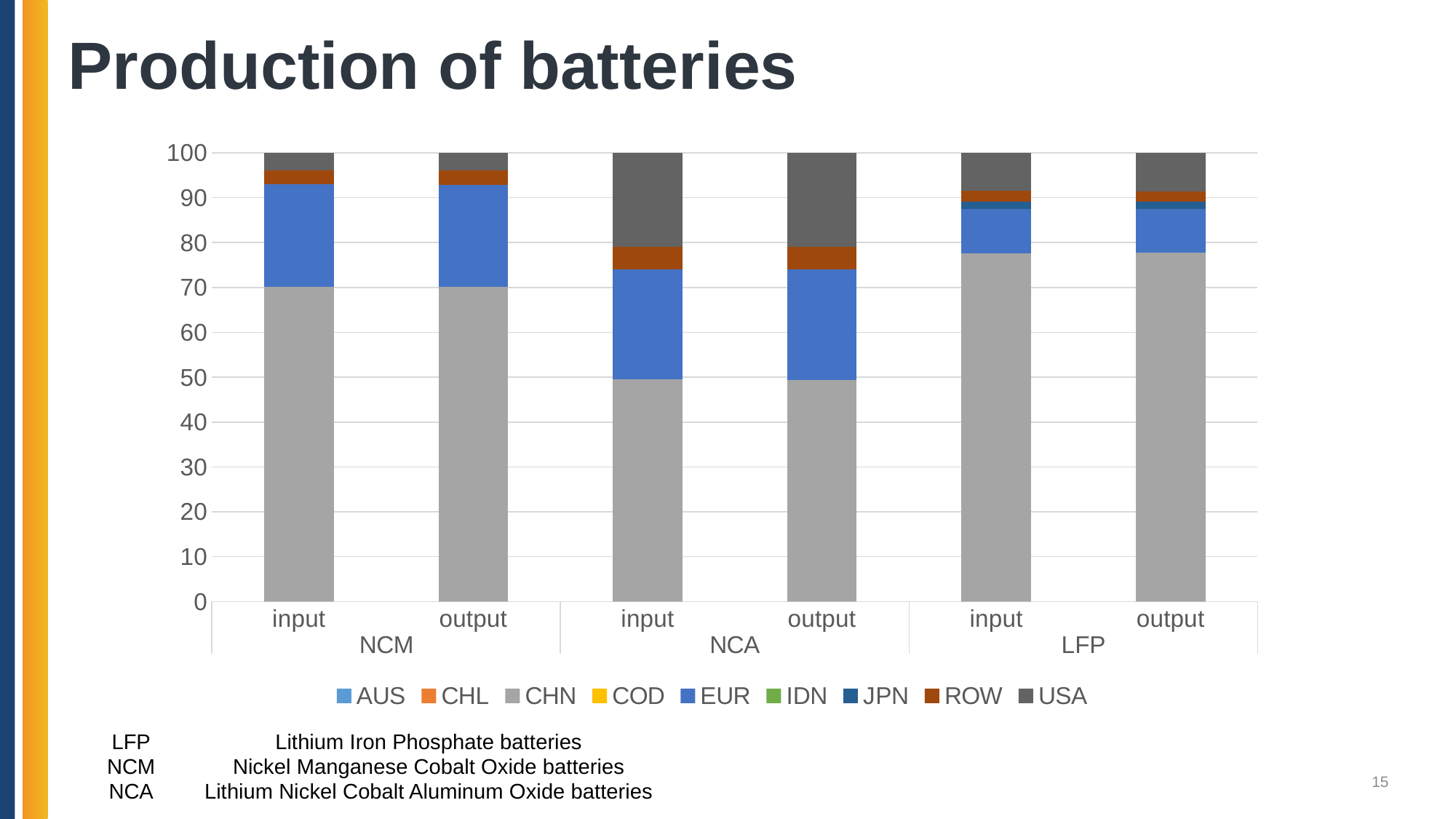
Is the EUR share larger in the NCA input bar or in the LFP input bar? NCA input Is the CHN share of the LFP output bar greater or less than 70? greater How many series does the legend list? 9 Is the CHN share of the NCM input bar greater or less than 60? greater Is the CHN share of the NCA input bar greater or less than 60? less Which three battery types are shown on the x axis? NCM, NCA, LFP Which battery type has the largest CHN share in its input bar? LFP How many bars are plotted in the chart? 6 Which battery type has the smallest CHN share in its input bar? NCA What kind of chart is shown on the slide? stacked bar chart What is the title of the slide containing the chart? Production of batteries